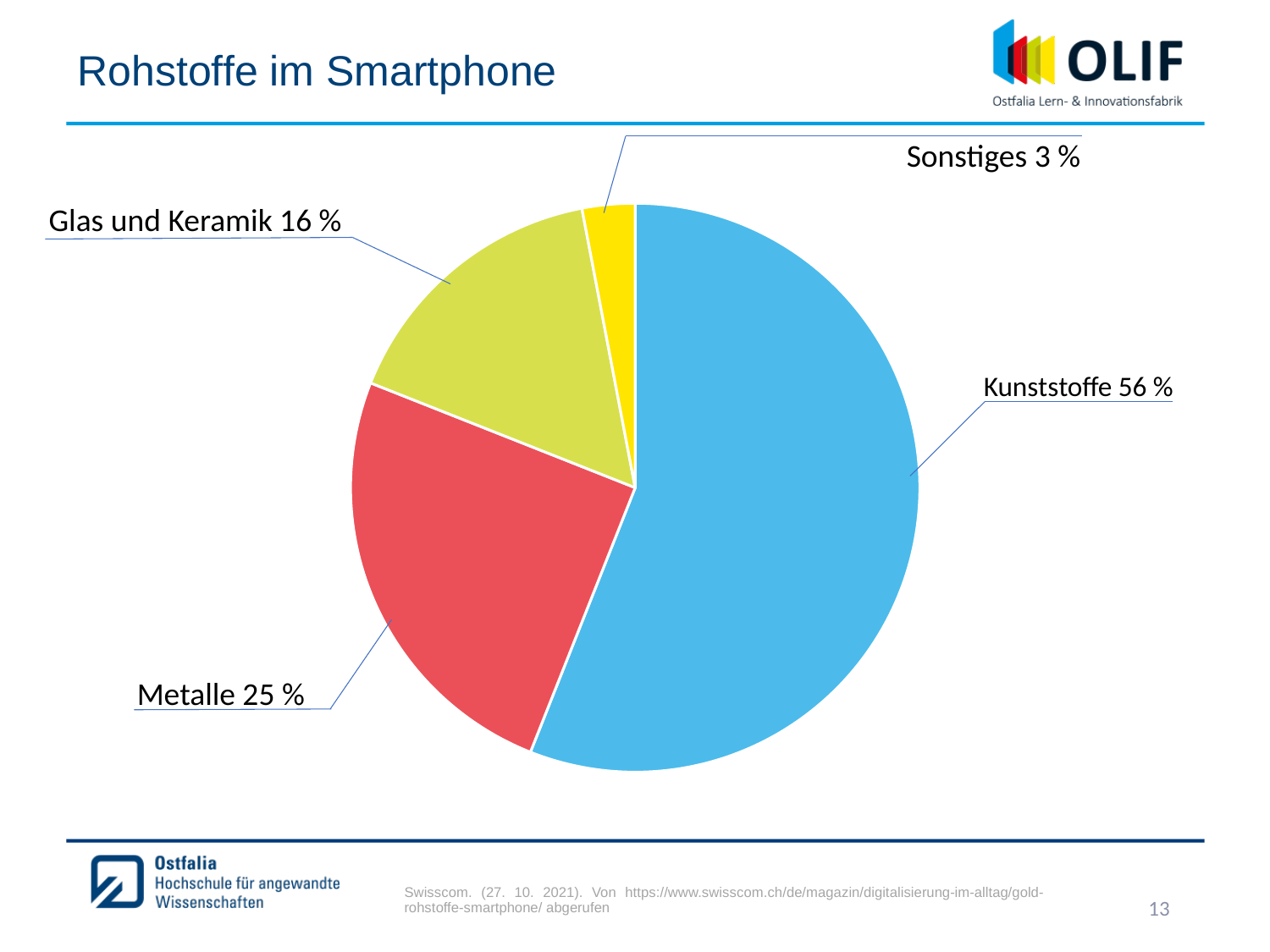
Which category has the smallest slice of the pie? Sonstiges What share of the pie does Metalle have? 25 % Which category has the largest slice of the pie? Kunststoffe Which is larger, the share for Metalle or the share for Glas und Keramik? Metalle What share of the pie does Glas und Keramik have? 16 % What colour is the slice for Metalle? red How many slices does the pie chart have? 4 What share of the pie does Sonstiges have? 3 % What is the difference in percentage points between Kunststoffe and Metalle? 31 What kind of chart is shown on the slide? pie chart What share of the pie does Kunststoffe have? 56 % What is the title of the slide containing the pie chart? Rohstoffe im Smartphone